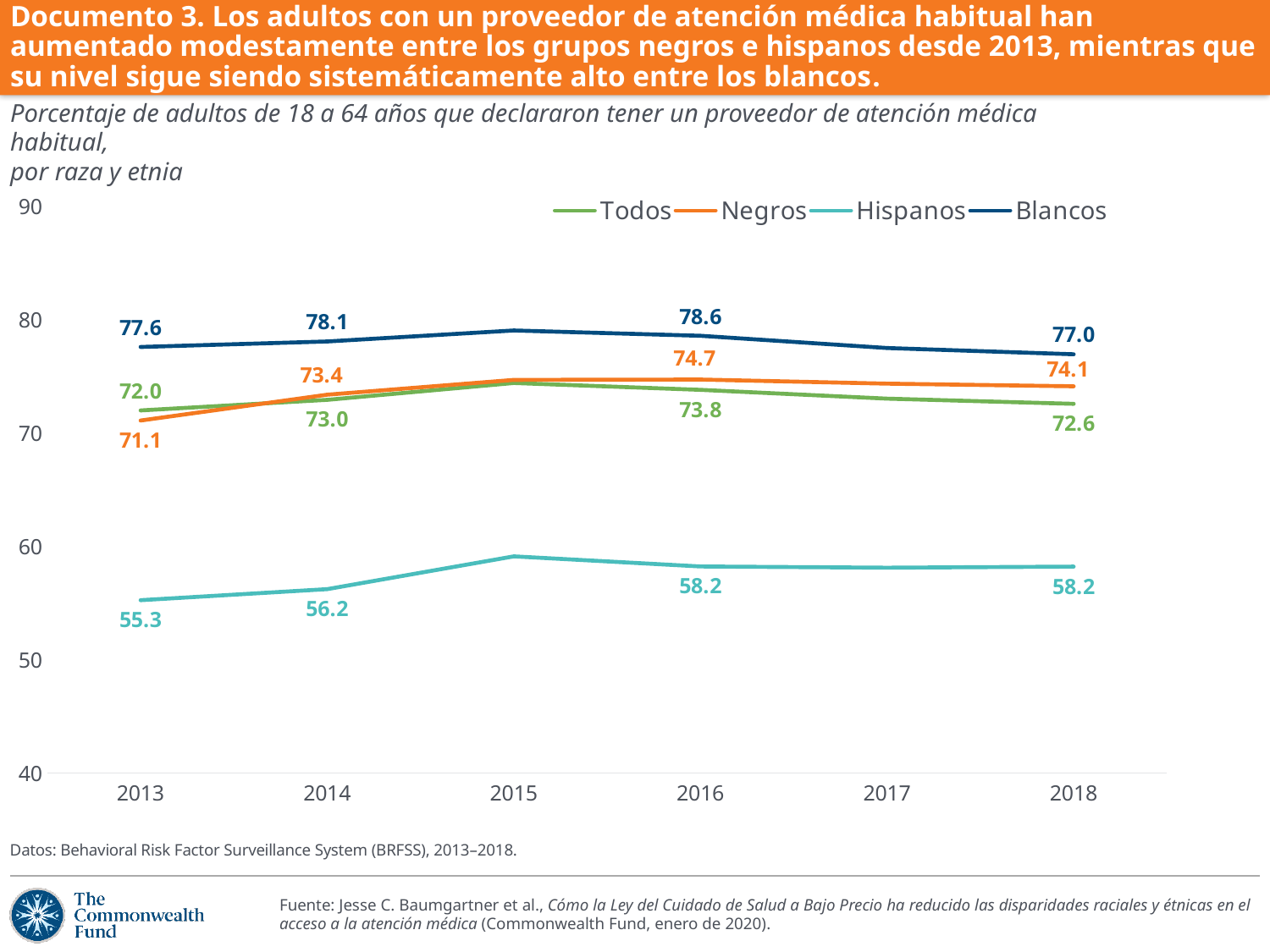
What is the value for Negros in 2016? 74.7 What kind of chart is shown on the slide? line chart Which group has the highest value in 2018? Blancos What is the value for Blancos in 2013? 77.6 Which is larger in 2013, the value for Todos or the value for Negros? Todos How many series does the legend list? 4 What is the value for Todos in 2014? 73.0 Which group has the lowest value in 2013? Hispanos What is the value for Hispanos in 2018? 58.2 Is the value for Hispanos in 2015 greater or less than 60? less What is the difference between the Blancos and Hispanos values in 2013? 22.3 How many years are shown on the x axis? 6